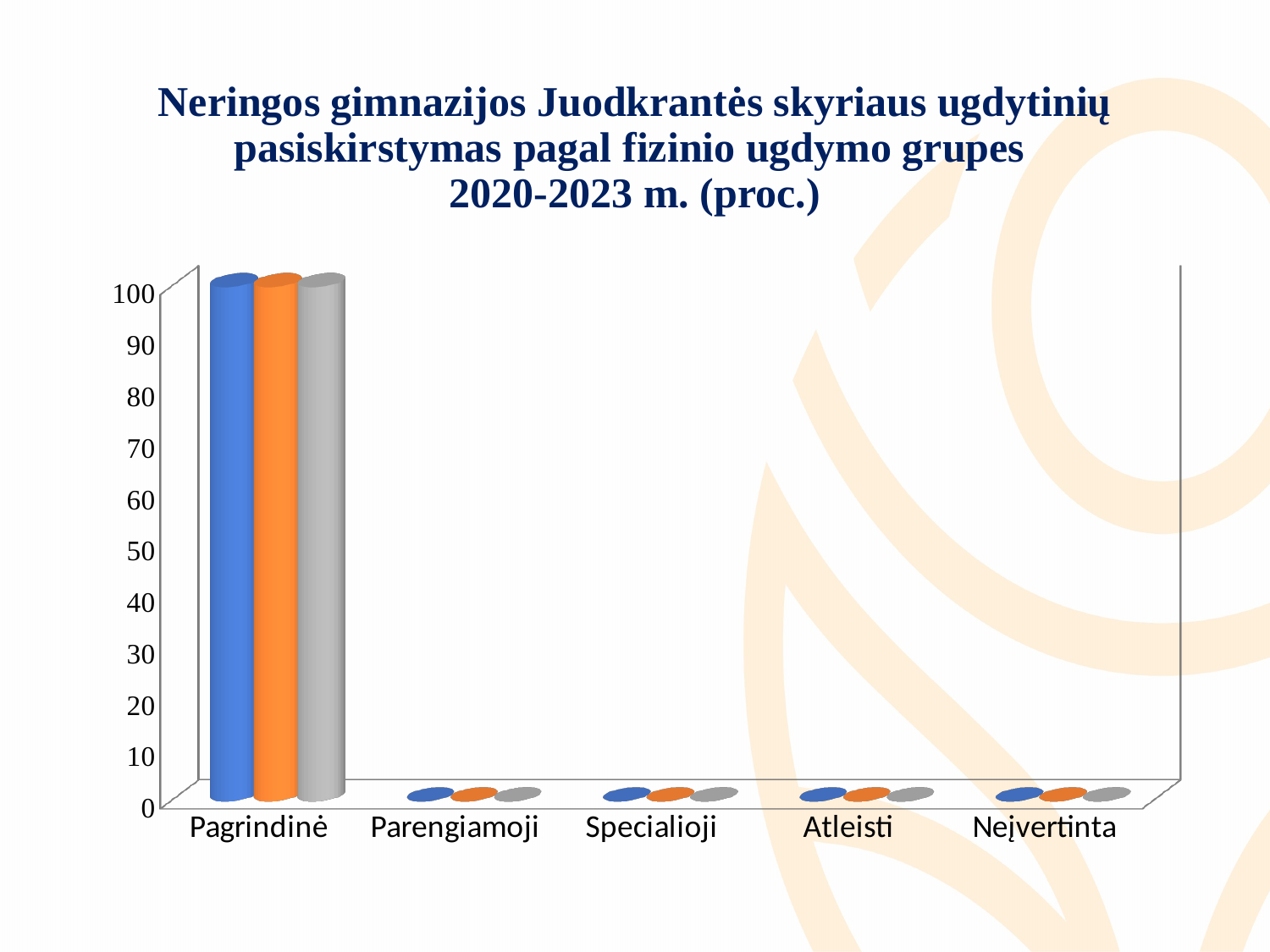
Which category has the highest values in the chart? Pagrindinė Is the value for Atleisti greater or less than 20? less What is the highest value shown on the vertical axis of the chart? 100 Which is larger, the value for Pagrindinė or the value for Specialioji? Pagrindinė How many categories are shown on the x axis of the chart? 5 Is the value for Pagrindinė greater or less than 50? greater How many bars are plotted for each category in the chart? 3 What is the last category label on the x axis of the chart? Neįvertinta Is the value for Parengiamoji greater or less than 10? less What kind of chart is shown on the slide? bar chart What value do the bars for Pagrindinė reach on the axis? 100 Which is larger, the value for Neįvertinta or the value for Pagrindinė? Pagrindinė